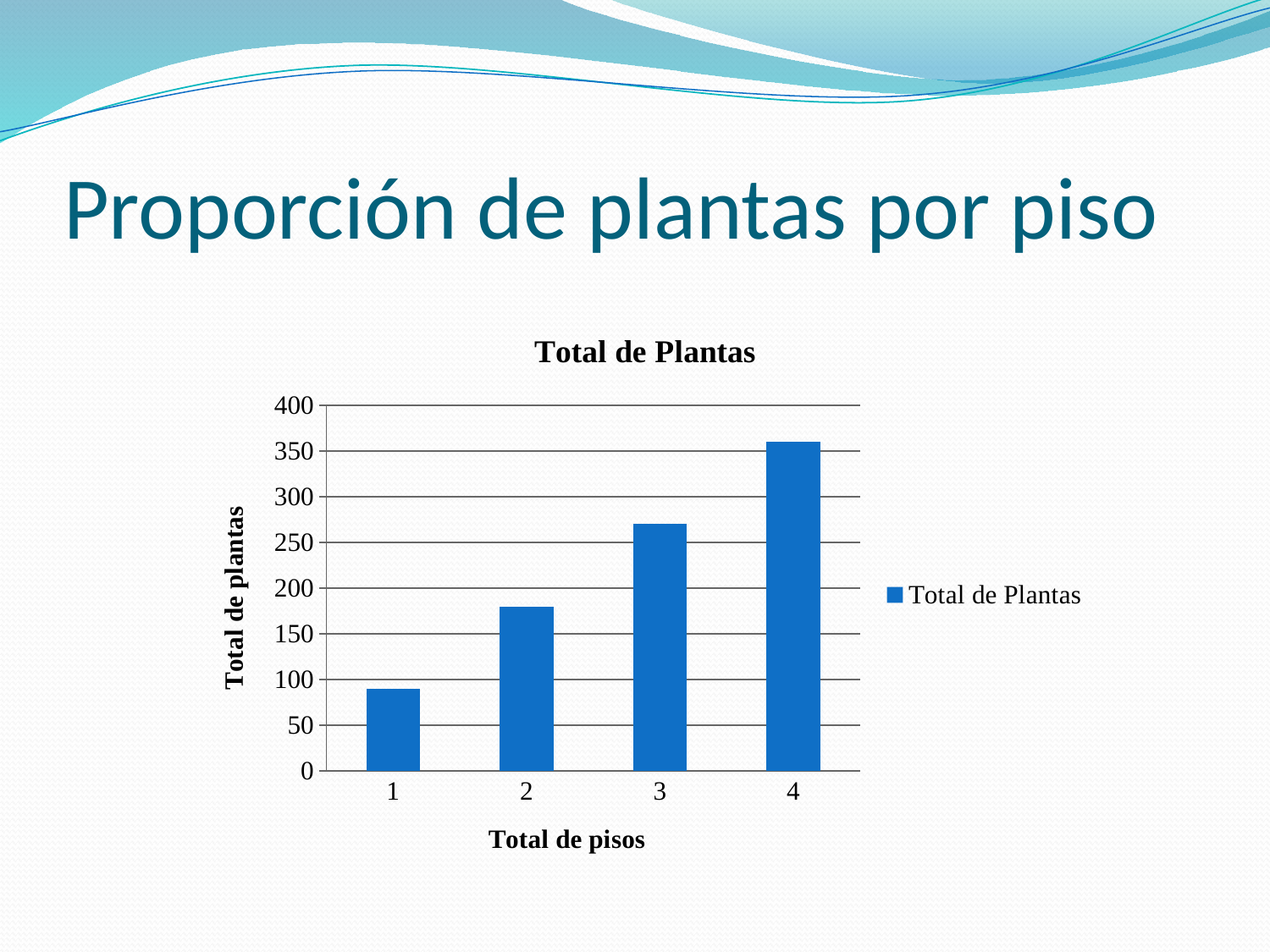
Which category on the x axis has the highest value? 4 Which is larger, the value for category 2 or the value for category 3? 3 How many bars (categories) does the chart show? 4 What kind of chart is shown on the slide? bar chart How many series does the legend list? 1 Is the value for category 2 greater or less than 150? greater Is the value for category 1 greater or less than 100? less Do the values rise or fall as you move from category 1 to category 4 along the x axis? rise Is the value for category 3 greater or less than 300? less What is the title of the chart? Total de Plantas Which category on the x axis has the lowest value? 1